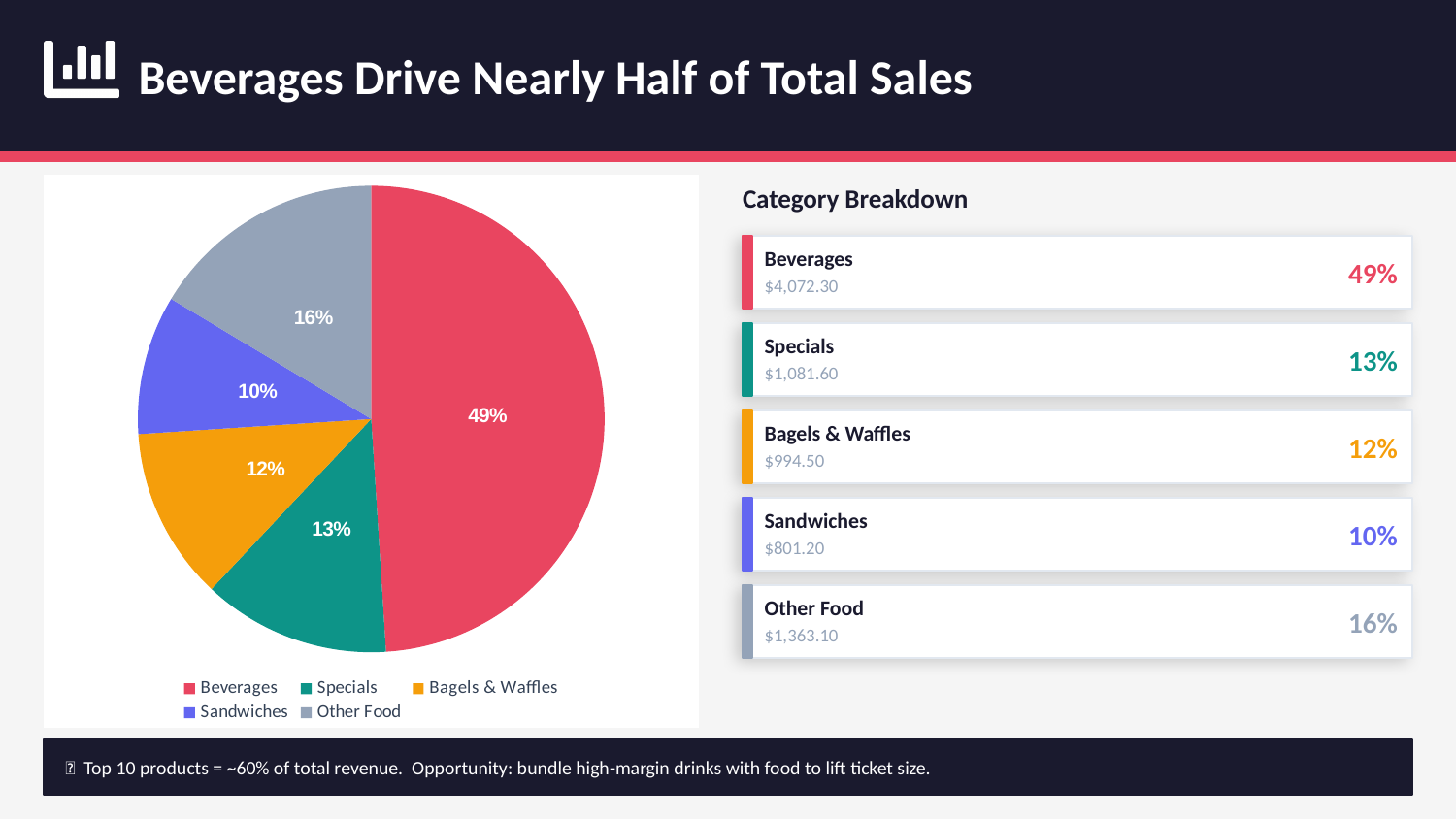
Which category has the largest slice of the pie? Beverages How many slices does the pie chart have? 5 What share of the pie does Specials account for? 13% Which slice is larger, Bagels & Waffles or Other Food? Other Food How many entries does the pie chart's legend list? 5 What share of the pie does Beverages account for? 49% What is the difference in percentage points between the Beverages slice and the Other Food slice? 33 What colour is the Bagels & Waffles slice in the pie chart? orange What share of the pie does Sandwiches account for? 10% Which category has the smallest slice of the pie? Sandwiches What type of chart is shown on the slide? pie chart